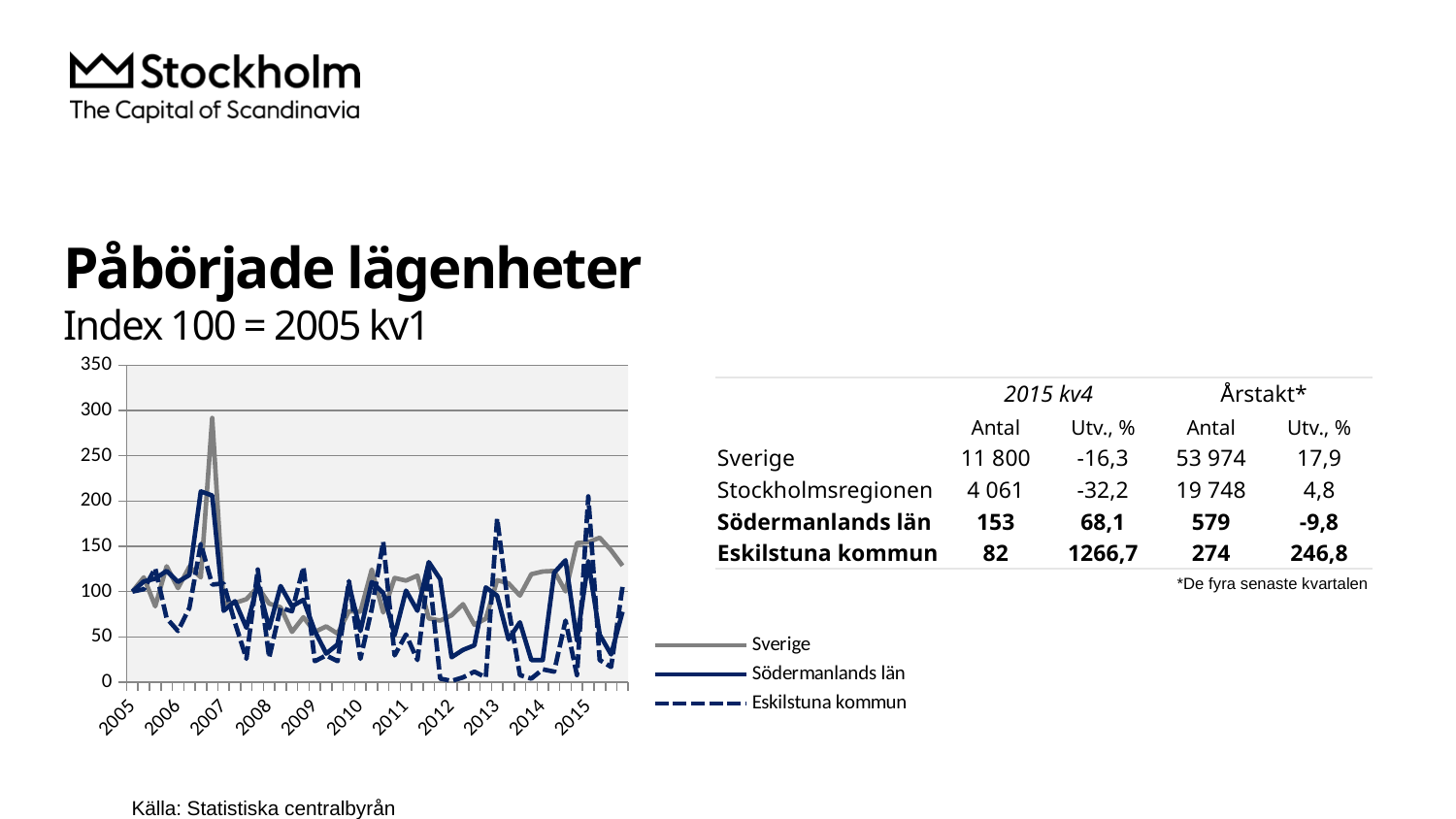
What kind of chart is shown on the slide? line chart Is the peak value for Södermanlands län around 2007 greater or less than 150? greater How many year labels are shown on the chart's x axis? 11 Is the peak value for Sverige around 2007 greater or less than 250? greater Which series in the chart is drawn with a dashed line? Eskilstuna kommun How many series does the chart legend list? 3 Which series drops to the lowest value in the chart? Eskilstuna kommun What is the title of the chart on the slide? Påbörjade lägenheter Around 2007, which series is higher: Sverige or Södermanlands län? Sverige What is the highest value shown on the chart's vertical axis? 350 Is the lowest value for Eskilstuna kommun around 2012 greater or less than 50? less Which series reaches the highest peak in the chart? Sverige